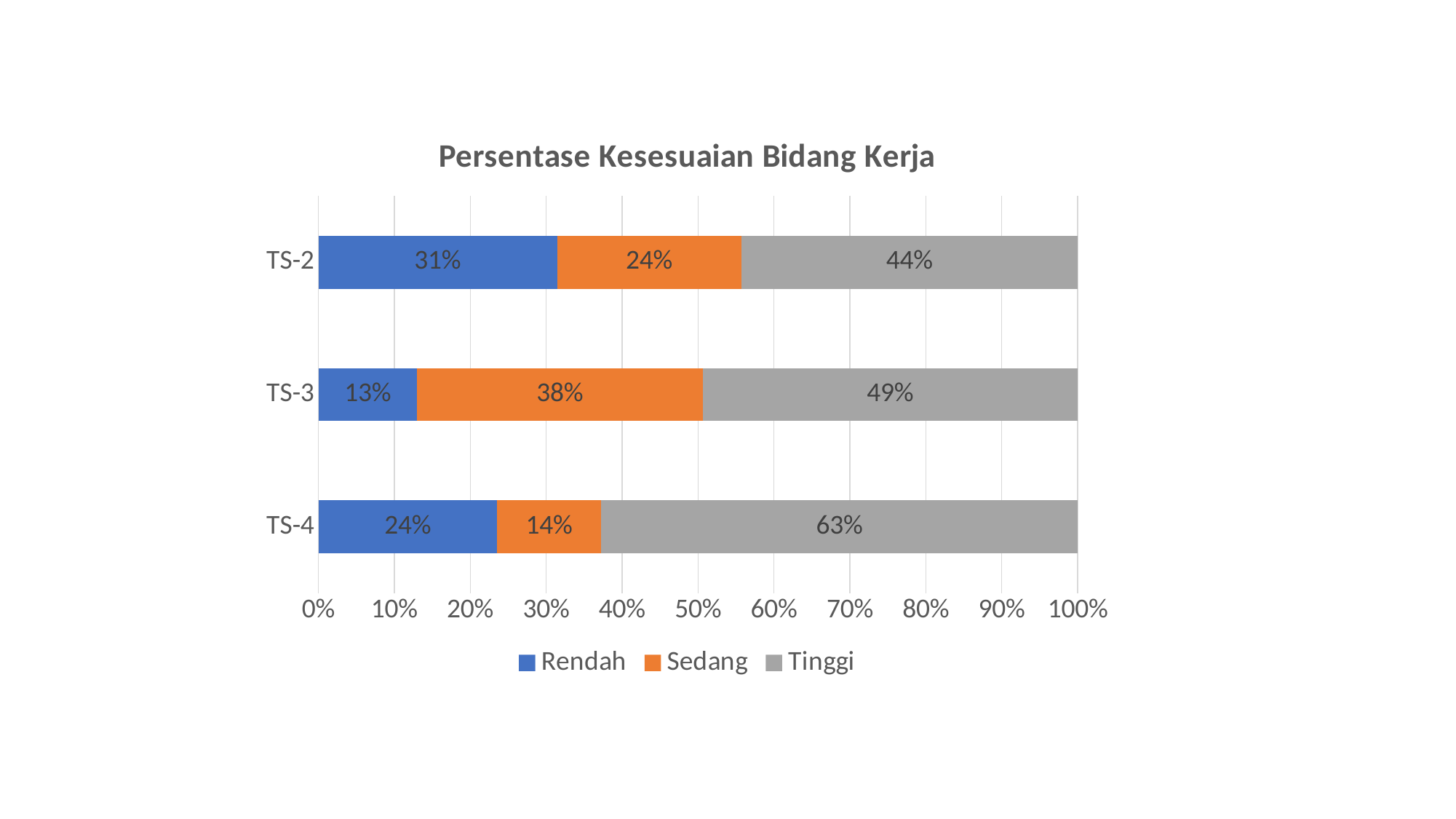
What is the Sedang value for TS-3? 38% Which category has the highest Tinggi value? TS-4 How many categories are shown on the chart? 3 Which category has the lowest Sedang value? TS-4 Which is larger, the Rendah value for TS-2 or the Rendah value for TS-4? TS-2 What is the difference between the Tinggi values for TS-4 and TS-2? 19% What is the difference between the Sedang values for TS-3 and TS-2? 14% How many series does the legend list? 3 What is the Rendah value for TS-2? 31% What is the Tinggi value for TS-4? 63% Which category has the lowest Rendah value? TS-3 What type of chart is shown on the slide? Stacked bar chart